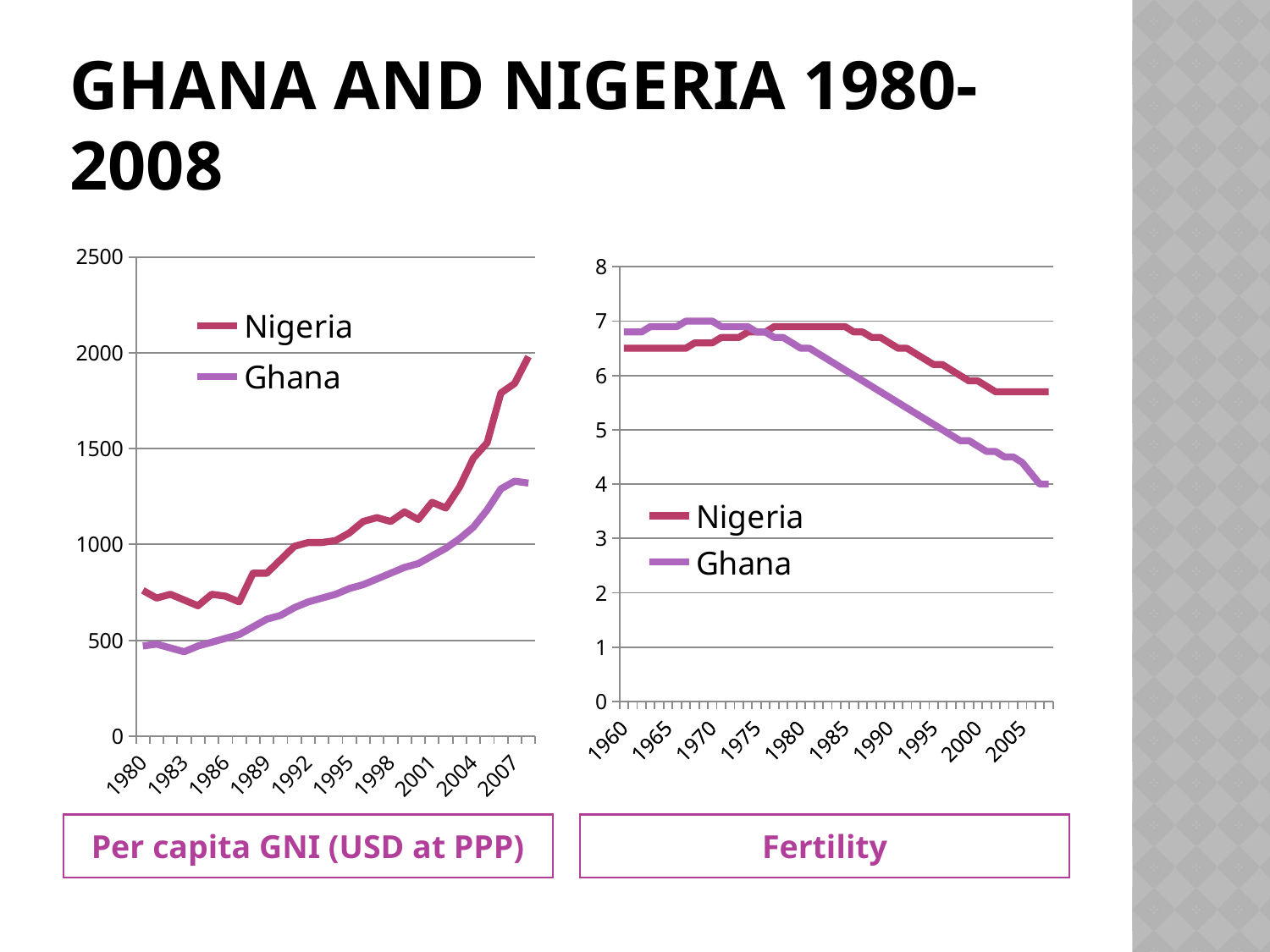
In the Fertility chart, is the value for Nigeria in 1960 greater or less than 6? greater In the Fertility chart, does the Ghana line rise or fall from 1970 to 2005? fall In the Per capita GNI (USD at PPP) chart, which country has the higher value in 2007, Nigeria or Ghana? Nigeria In the Fertility chart, which colour is used for the Ghana line? purple In the Per capita GNI (USD at PPP) chart, does the Ghana line generally rise or fall from 1980 to 2007? rise In the Fertility chart, which country has the higher value in 2005, Nigeria or Ghana? Nigeria In the Fertility chart, is the value for Ghana in 2005 greater or less than 5? less What kind of chart is the Fertility chart on the right? line chart How many series does the legend of the Per capita GNI (USD at PPP) chart list? 2 What kind of chart is the Per capita GNI (USD at PPP) chart on the left? line chart In the Per capita GNI (USD at PPP) chart, is the value for Ghana in 1983 greater or less than 500? less